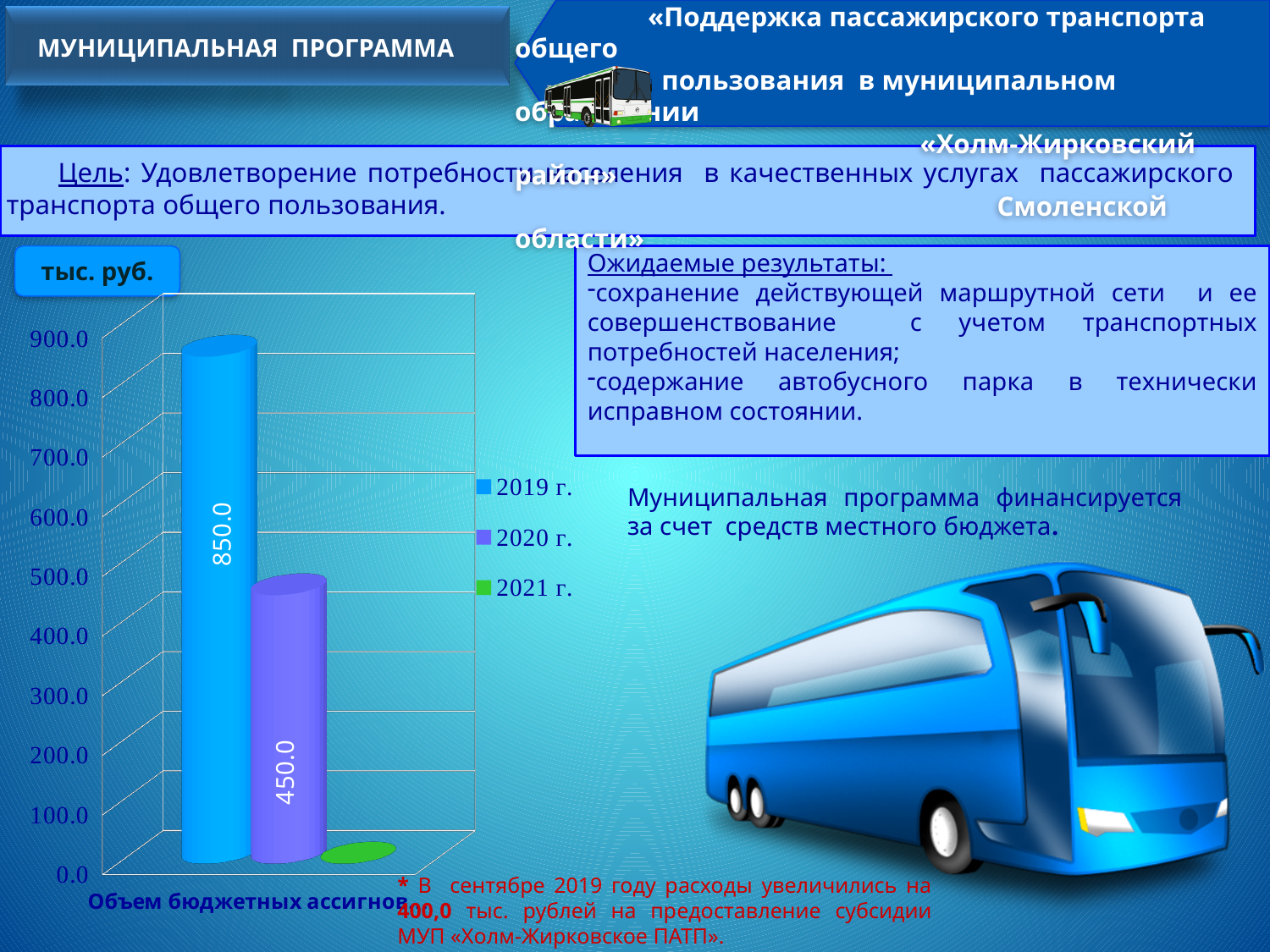
Which year has the lowest value in the bar chart? 2021 г. What is the value for 2019 г. in the bar chart? 850.0 Is the value for 2021 г. greater or less than 100.0? less What kind of chart is shown on the slide? bar chart What is the value for 2020 г. in the bar chart? 450.0 What unit is shown in the label above the chart's vertical axis? тыс. руб. Is the value for 2020 г. greater or less than 500.0? less How many series does the legend of the chart list? 3 Which year has the highest value in the bar chart? 2019 г. Do the values rise or fall from 2019 г. to 2021 г.? fall What is the difference between the values for 2019 г. and 2020 г.? 400.0 Which is larger, the value for 2019 г. or the value for 2020 г.? 2019 г.